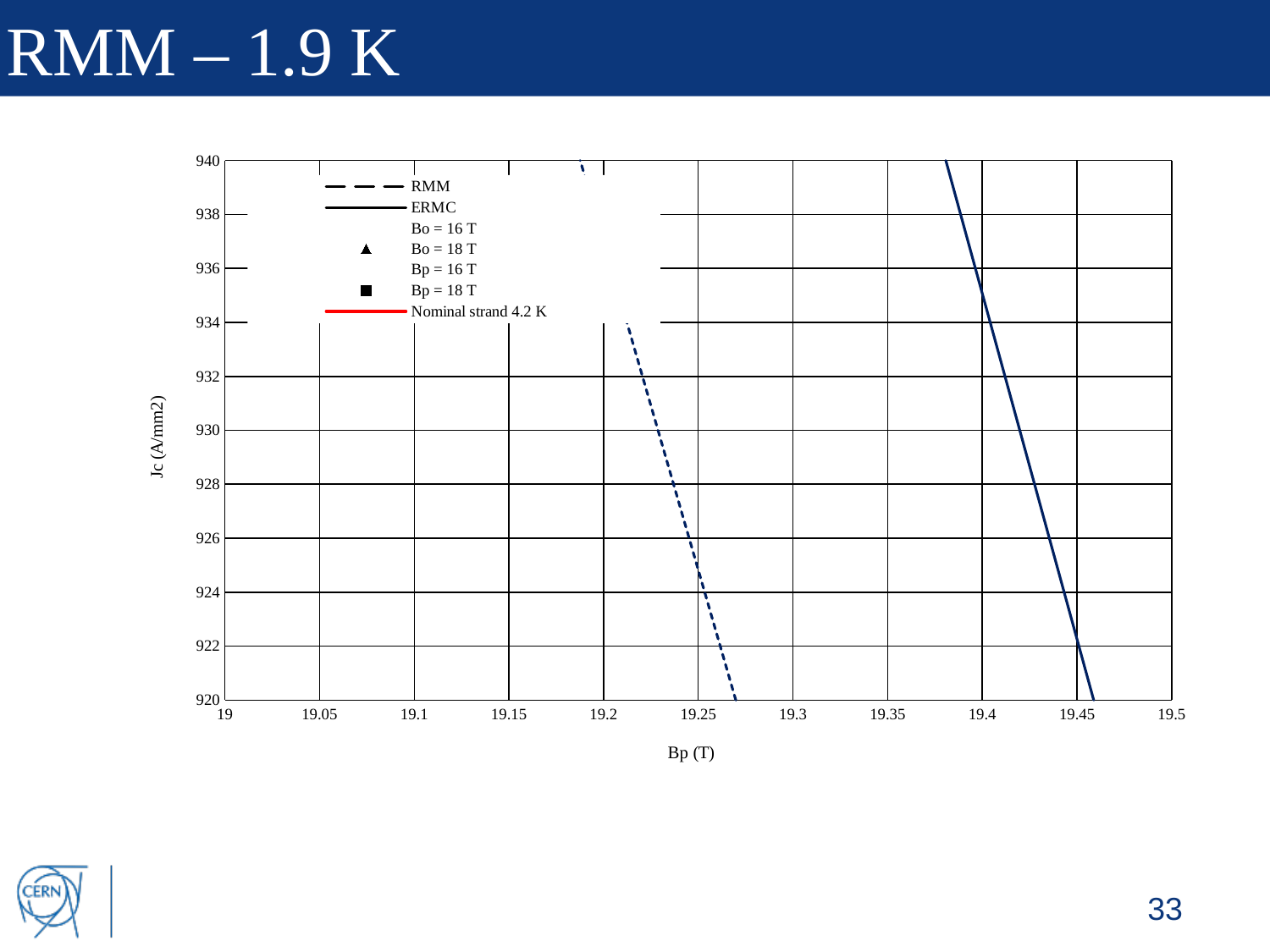
Is the Jc value of the RMM curve at Bp = 19.25 T greater or less than 928? less Is the Jc value of the ERMC curve at Bp = 19.4 T greater or less than 930? greater Which legend entry is drawn with a dashed line? RMM What is the label of the x axis? Bp (T) How many entries does the legend list? 7 Is the Jc value of the RMM curve at Bp = 19.2 T greater or less than 936? greater What kind of chart is shown on the slide? line chart At Jc = 930 A/mm2, which curve is at the larger Bp value, RMM or ERMC? ERMC Which curve reaches Jc = 920 A/mm2 at the smaller Bp value, RMM or ERMC? RMM Does the ERMC curve rise or fall as Bp increases? fall Does the RMM curve rise or fall as Bp increases? fall